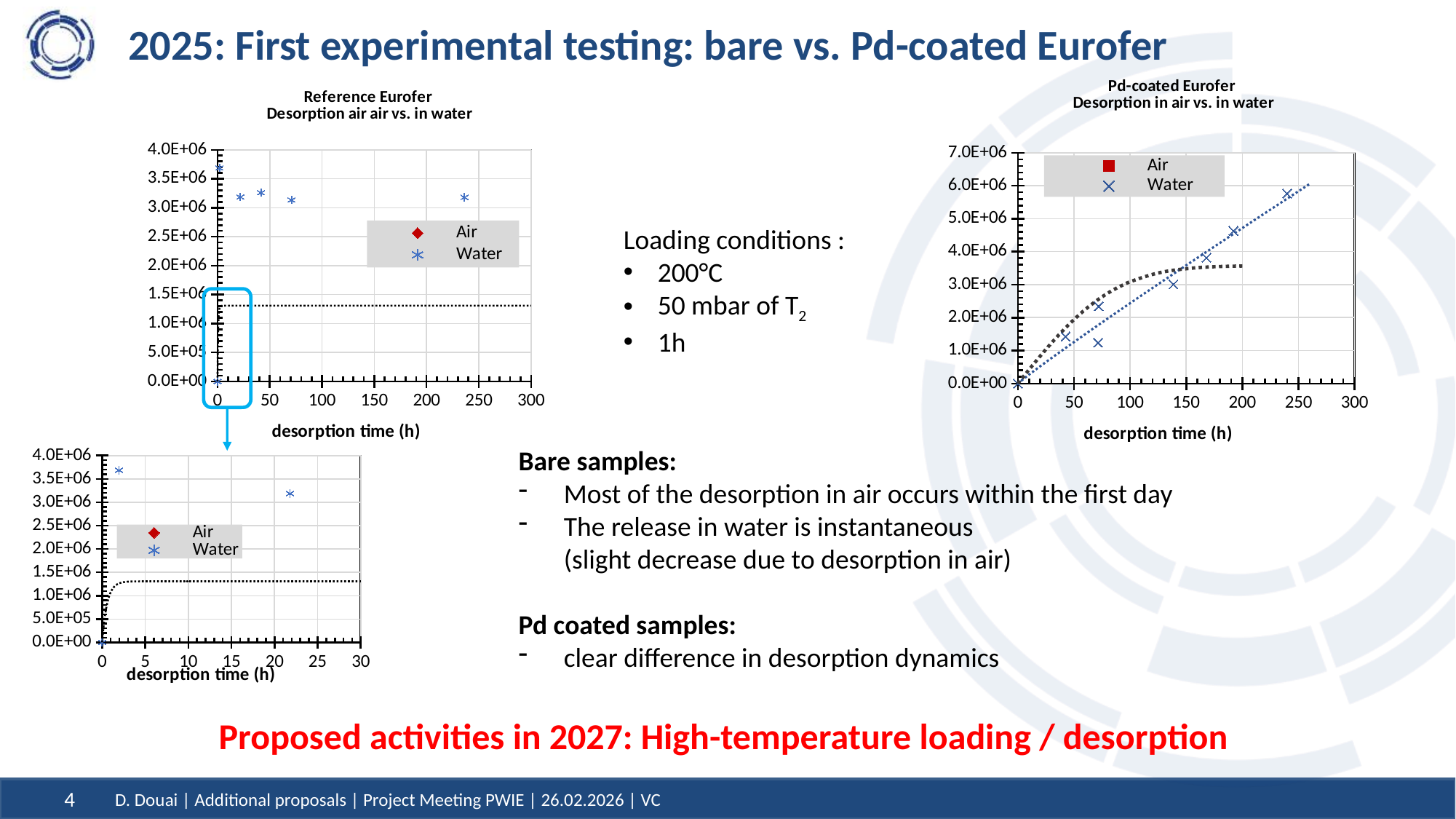
What is the x-axis label of the 'Pd-coated Eurofer' chart? desorption time (h) How many series does the legend of the 'Pd-coated Eurofer' chart list? 2 In the 'Pd-coated Eurofer' chart, which is larger: the Water value at about 240 h or at about 200 h? about 240 h What is the highest y-axis tick value shown on the 'Pd-coated Eurofer' chart? 7.0E+06 In the 'Reference Eurofer' chart, is the Water value at about 240 h greater or less than 3.5E+06? less In the 'Pd-coated Eurofer' chart, is the Water value at about 200 h greater or less than 4.0E+06? greater In the 'Pd-coated Eurofer' chart, do the Water values rise or fall as desorption time increases? rise In the 'Pd-coated Eurofer' chart, is the Water value at about 240 h greater or less than 5.0E+06? greater What kind of chart is the 'Reference Eurofer Desorption air air vs. in water' chart? scatter chart How many series does the legend of the 'Reference Eurofer' chart list? 2